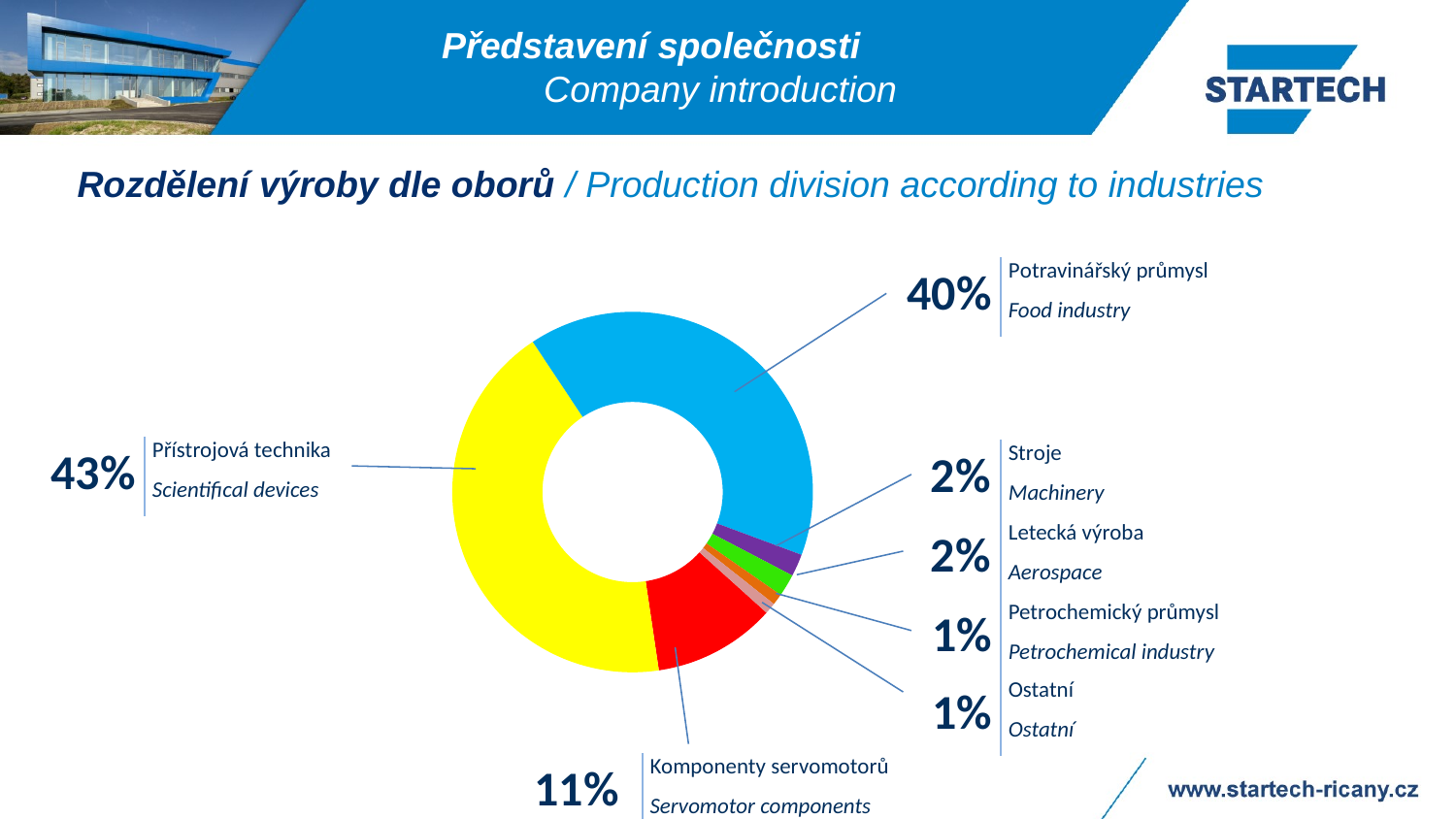
Which is larger, the share for Machinery or the share for Servomotor components? Servomotor components What share of production does the Food industry account for? 40% What percentage of production is Servomotor components? 11% Which industry has the largest share of production? Scientific devices What share of production is attributed to Scientific devices? 43% What colour is the slice representing the Food industry? Blue How many industry categories are shown in the chart? 7 What type of chart is used to show the production division? Pie chart (donut) What share does the Petrochemical industry have in the production division? 1% What is the difference in percentage points between Food industry and Servomotor components? 29 What is the combined share of Machinery and Aerospace? 4% What is the difference in percentage points between Scientific devices and Food industry? 3